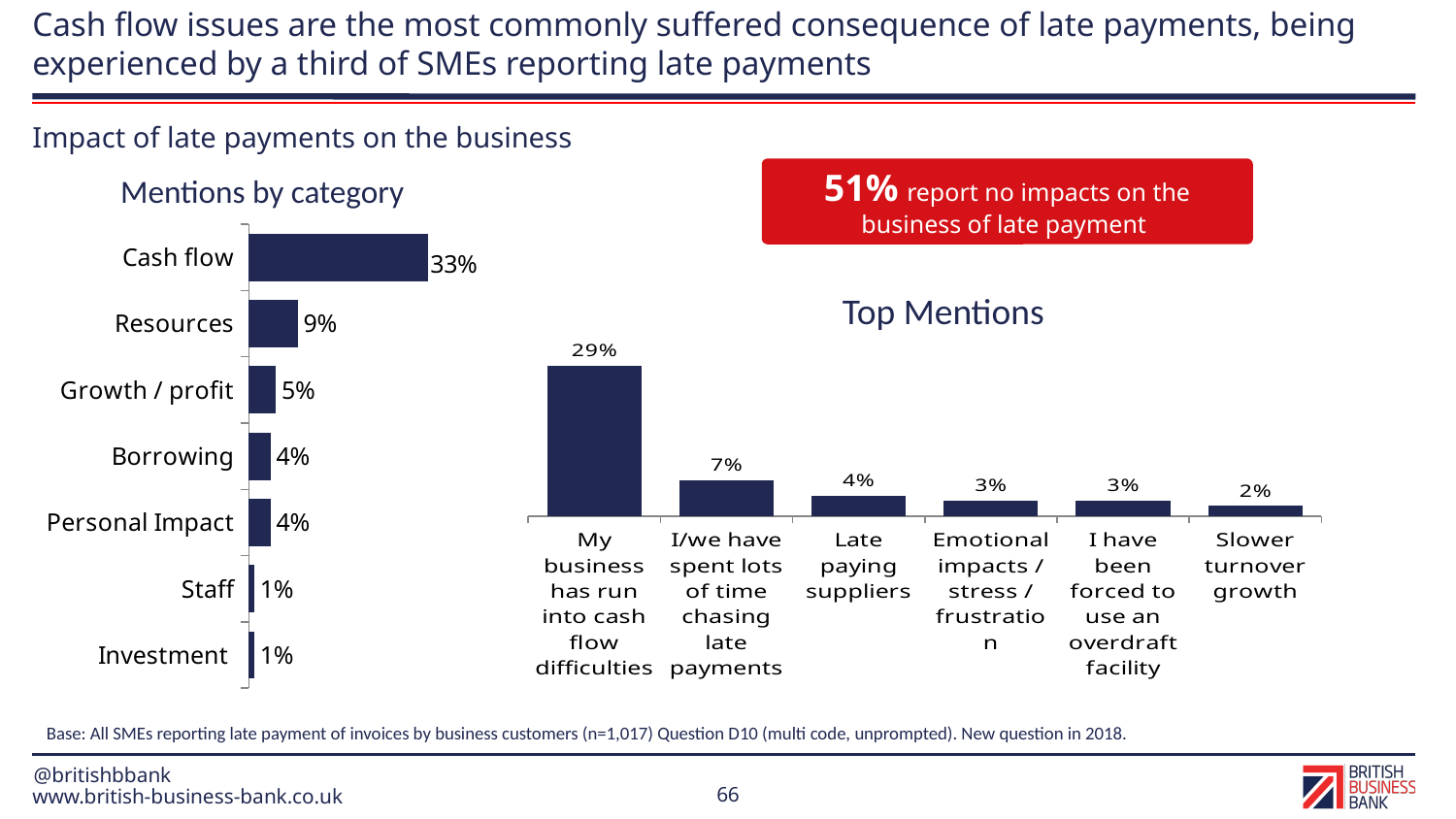
In the 'Mentions by category' chart, what is the value for Resources? 9% What kind of chart is the 'Top Mentions' chart? Bar chart In the 'Mentions by category' chart, what is the difference between Cash flow and Resources? 24% In the 'Top Mentions' chart, what is the value for 'My business has run into cash flow difficulties'? 29% In the 'Top Mentions' chart, what is the value for 'Late paying suppliers'? 4% In the 'Mentions by category' chart, which category has the highest value? Cash flow In the 'Top Mentions' chart, what is the difference between 'My business has run into cash flow difficulties' and 'I/we have spent lots of time chasing late payments'? 22% In the 'Mentions by category' chart, which is larger, Growth / profit or Borrowing? Growth / profit In the 'Top Mentions' chart, how many categories are shown? 6 In the 'Mentions by category' chart, how many categories are shown? 7 In the 'Mentions by category' chart, what is the value for Cash flow? 33% In the 'Top Mentions' chart, which category has the lowest value? Slower turnover growth